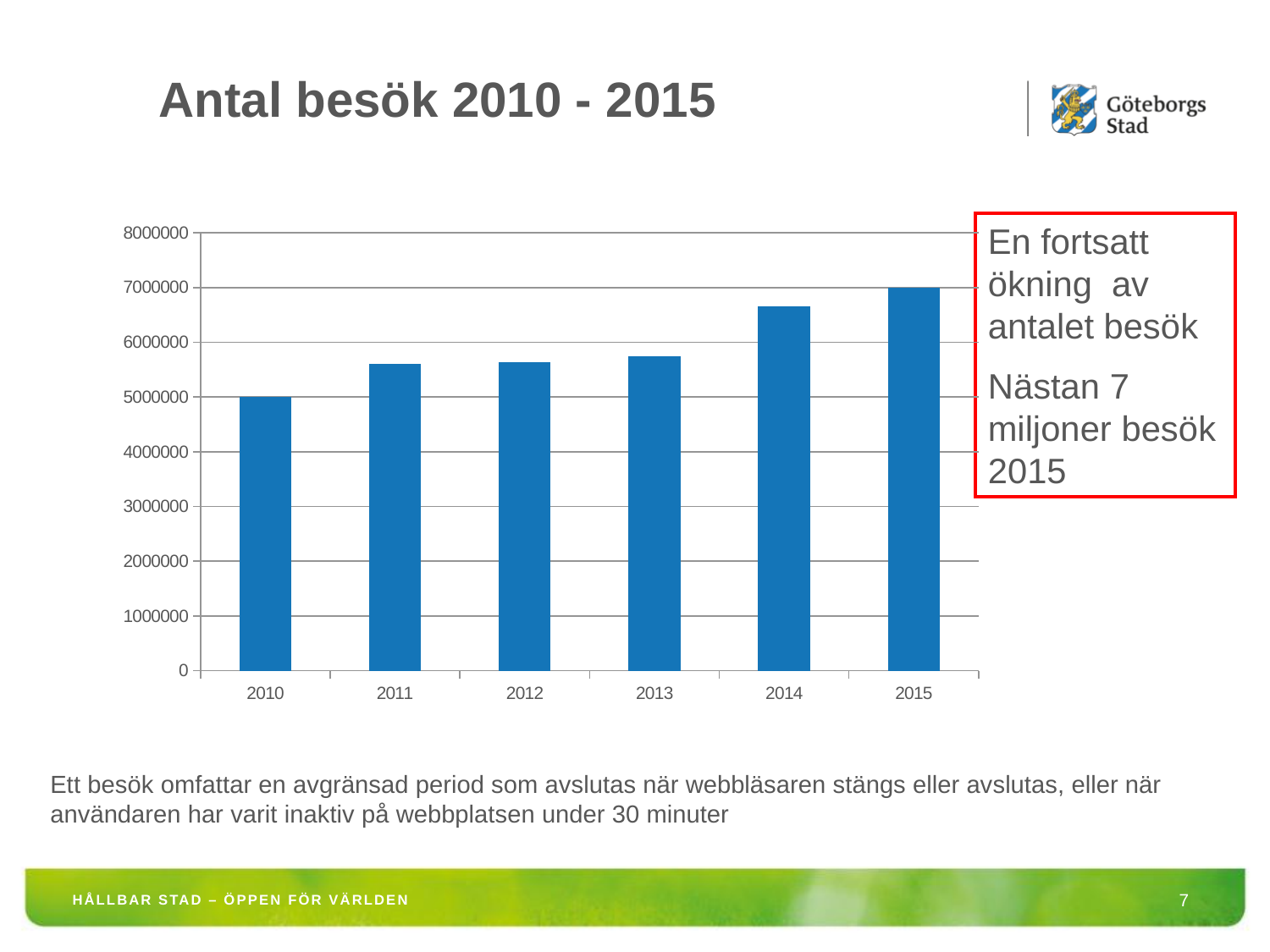
How many years (bars) are shown in the chart? 6 Which year has the highest number of visits in the chart? 2015 Which year has more visits, 2013 or 2014? 2014 What is the title of the slide containing the chart? Antal besök 2010 - 2015 Do the values rise or fall from 2010 to 2015? rise What kind of chart is shown on the slide? bar chart Is the value for 2013 greater or less than 6000000? less Is the value for 2014 greater or less than 6000000? greater Which year has the lowest number of visits in the chart? 2010 Which year has more visits, 2010 or 2011? 2011 Is the value for 2012 greater or less than 6000000? less